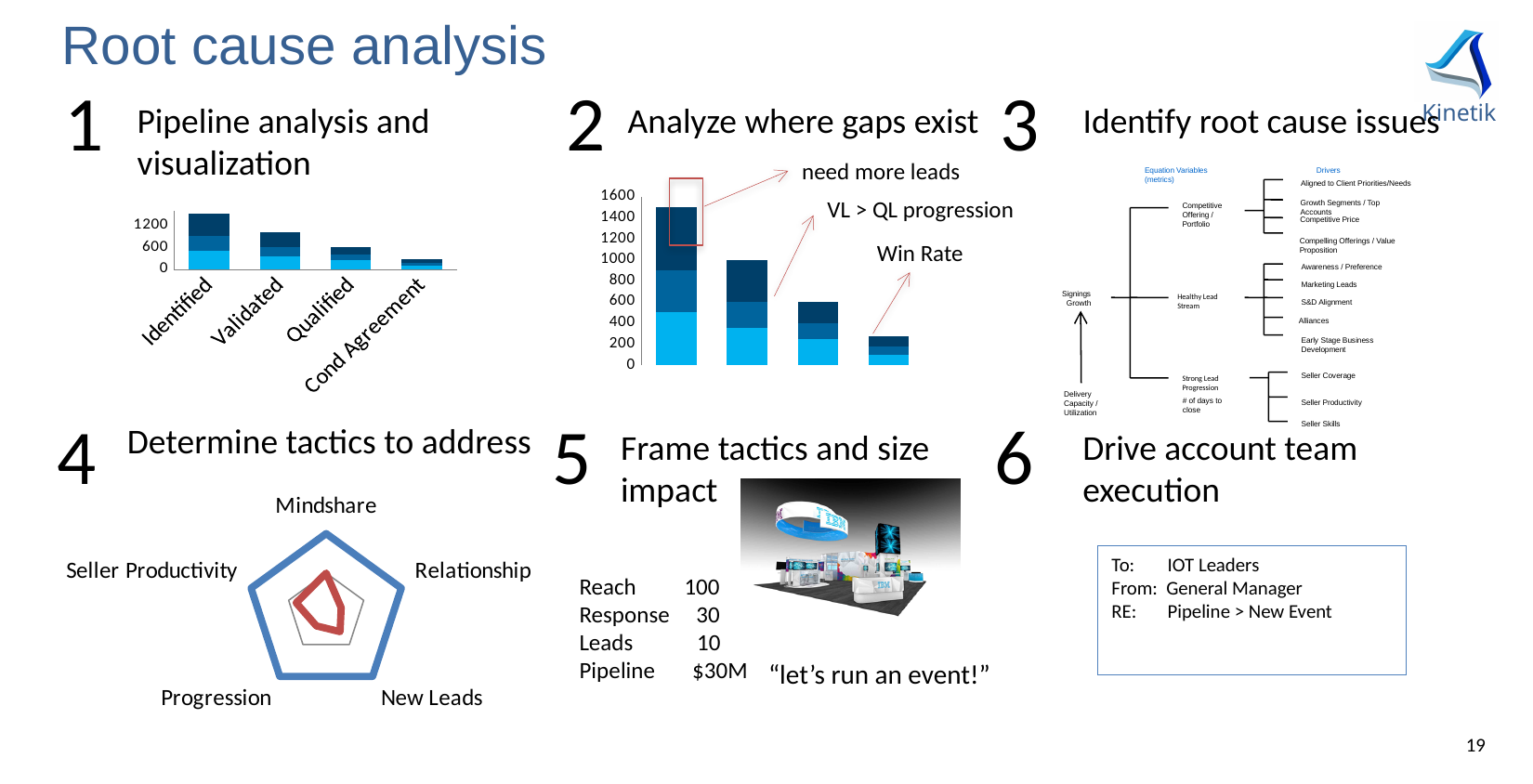
In the chart under step 1 'Pipeline analysis and visualization', is the total value for Cond Agreement greater or less than 600? less In the chart under step 4 'Determine tactics to address', how many axes (categories) does the radar chart have? 5 In the chart under step 2 'Analyze where gaps exist', is the total of the rightmost bar greater or less than 400? less In the chart under step 2 'Analyze where gaps exist', is the total of the first (leftmost) bar greater or less than 1200? greater In the chart under step 1 'Pipeline analysis and visualization', do the bar totals rise or fall from left to right? fall In the chart under step 1 'Pipeline analysis and visualization', what kind of chart is shown? stacked bar chart In the chart under step 2 'Analyze where gaps exist', what is the highest value shown on the y axis? 1600 In the chart under step 1 'Pipeline analysis and visualization', how many categories are shown on the x axis? 4 In the chart under step 2 'Analyze where gaps exist', how many bars are shown? 4 In the chart under step 1 'Pipeline analysis and visualization', which category has the highest total bar? Identified In the chart under step 1 'Pipeline analysis and visualization', which category has the lowest total bar? Cond Agreement